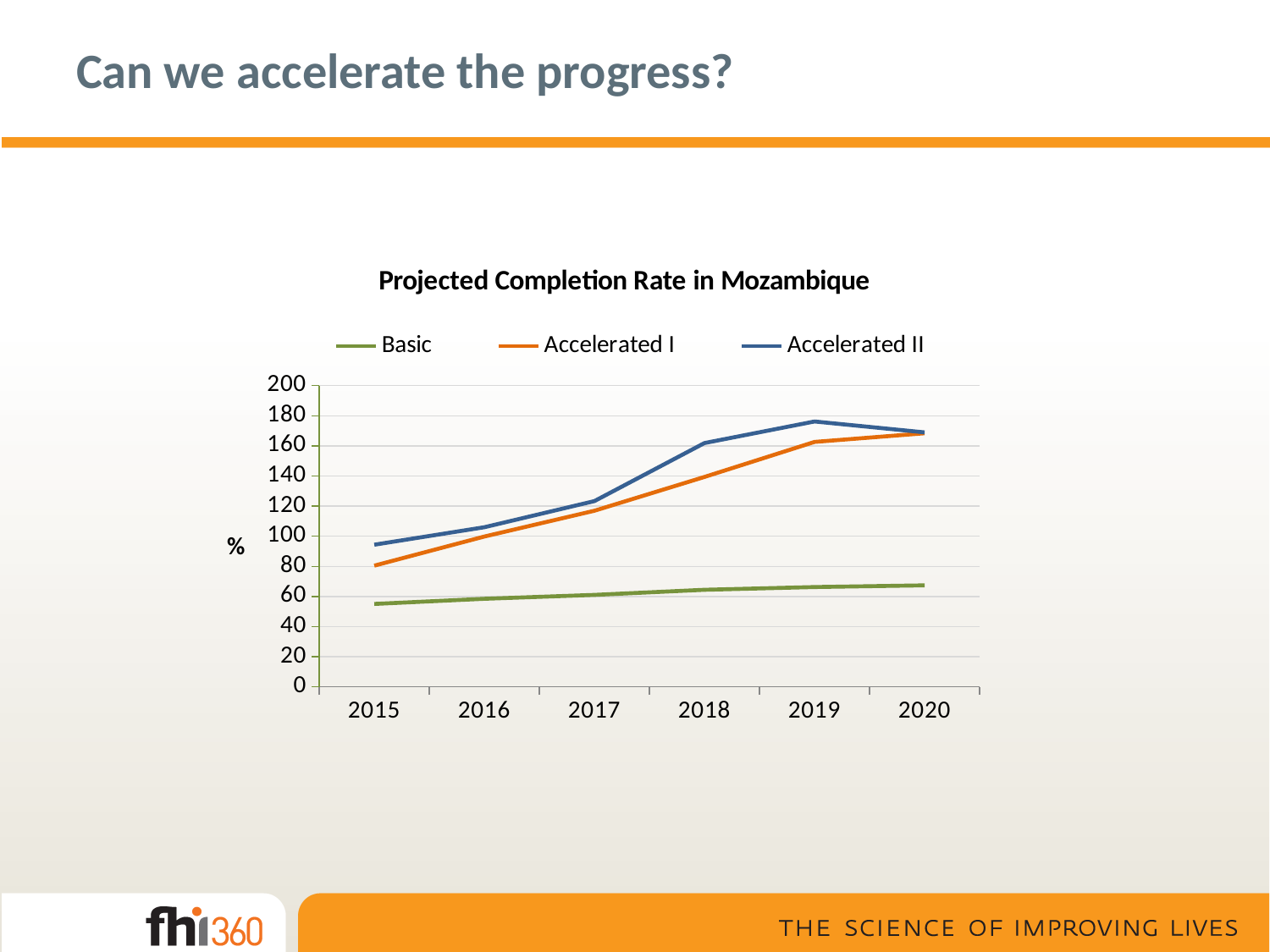
What kind of chart is shown on the slide? line chart In 2018, which is larger: Accelerated I or Accelerated II? Accelerated II What is the title of the chart? Projected Completion Rate in Mozambique How many series does the legend list? 3 Does the Basic series rise or fall from 2015 to 2020? rise How many years are shown along the x axis? 6 Is the value for Basic in 2020 greater or less than 80? less What label is shown on the vertical axis? % Is the value for Accelerated I in 2015 greater or less than 100? less Is the value for Accelerated II in 2019 greater or less than 160? greater Which series has the lowest value in 2017? Basic Which series has the highest value in 2019? Accelerated II